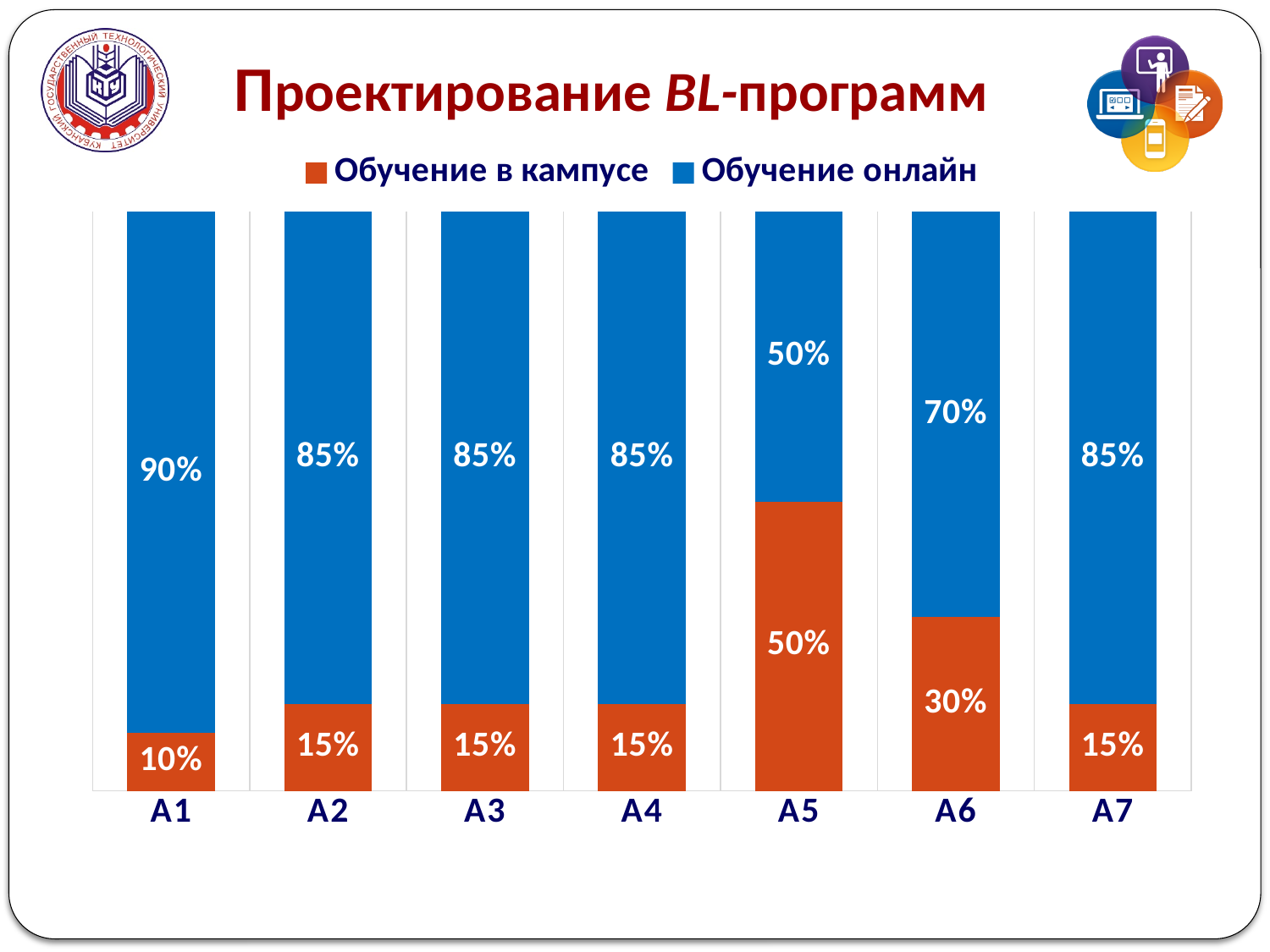
What is the value for "Обучение онлайн" for A2? 85% Which is larger: the "Обучение онлайн" value for A5 or for A7? A7 How many series does the legend list? 2 What kind of chart is shown on the slide? Stacked bar chart What is the difference between the "Обучение в кампусе" values for A6 and A2? 15% What is the value for "Обучение в кампусе" for A5? 50% What is the value for "Обучение в кампусе" for A1? 10% Which category has the highest value for "Обучение онлайн"? A1 Which category has the highest value for "Обучение в кампусе"? A5 Which category has the lowest value for "Обучение в кампусе"? A1 What is the value for "Обучение онлайн" for A6? 70% How many categories are shown on the x axis? 7